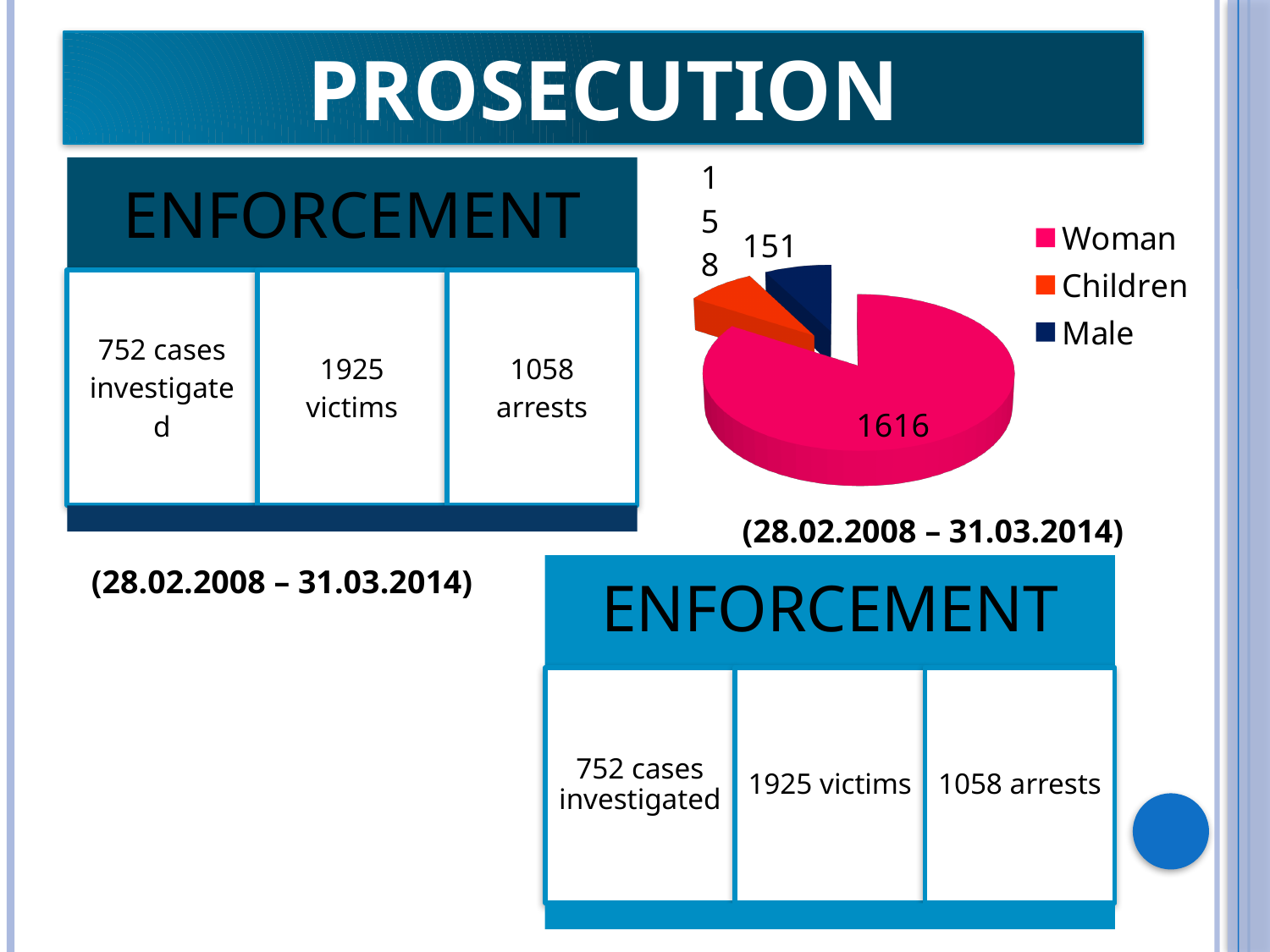
In the pie chart, what is the value for Children? 158 What is the difference between the Children and Male values in the pie chart? 7 Which category has the smallest slice in the pie chart? Male Which category has the largest slice in the pie chart? Woman In the pie chart, what is the value for Woman? 1616 How many categories does the pie chart show? 3 In the pie chart, what is the value for Male? 151 What is the difference between the Woman and Children values in the pie chart? 1458 What colour is the Woman slice in the pie chart? pink What type of chart is shown on the slide? pie chart Which is larger in the pie chart, Children or Male? Children How many entries does the pie chart legend list? 3